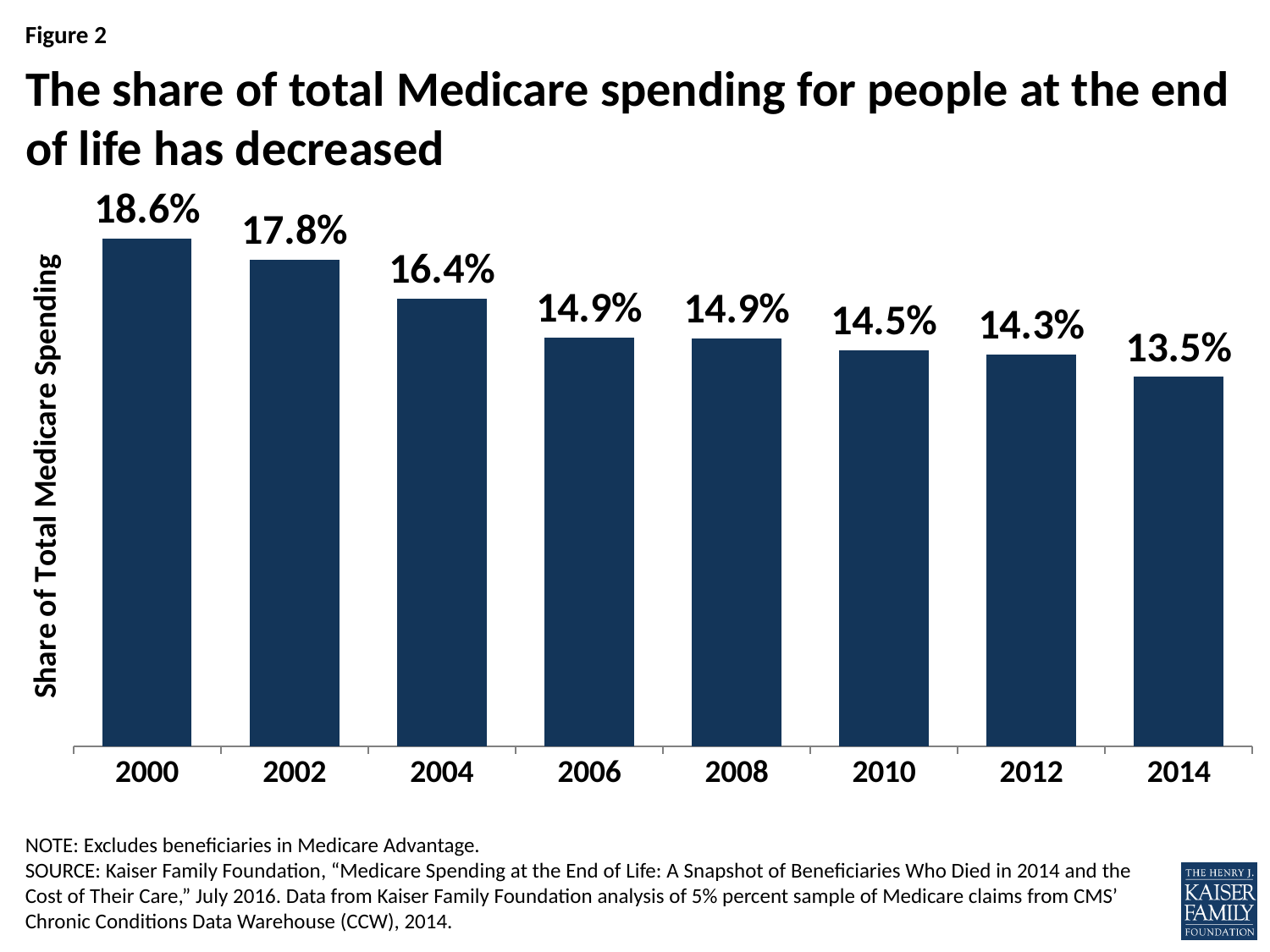
Which year has the highest share of total Medicare spending? 2000 What is the difference between the 2002 value and the 2004 value? 1.4 percentage points Which year has the lowest share of total Medicare spending? 2014 What is the share of total Medicare spending for people at the end of life in 2000? 18.6% What value is shown for 2010? 14.5% What is the share of total Medicare spending for people at the end of life in 2014? 13.5% What value is shown for 2004? 16.4% Do the values generally rise or fall from 2000 to 2014? Fall What is the difference in percentage points between the 2000 value and the 2014 value? 5.1 percentage points What kind of chart is shown on the slide? Bar chart How many years are shown on the x axis? 8 Which is larger, the value for 2012 or the value for 2014? 2012